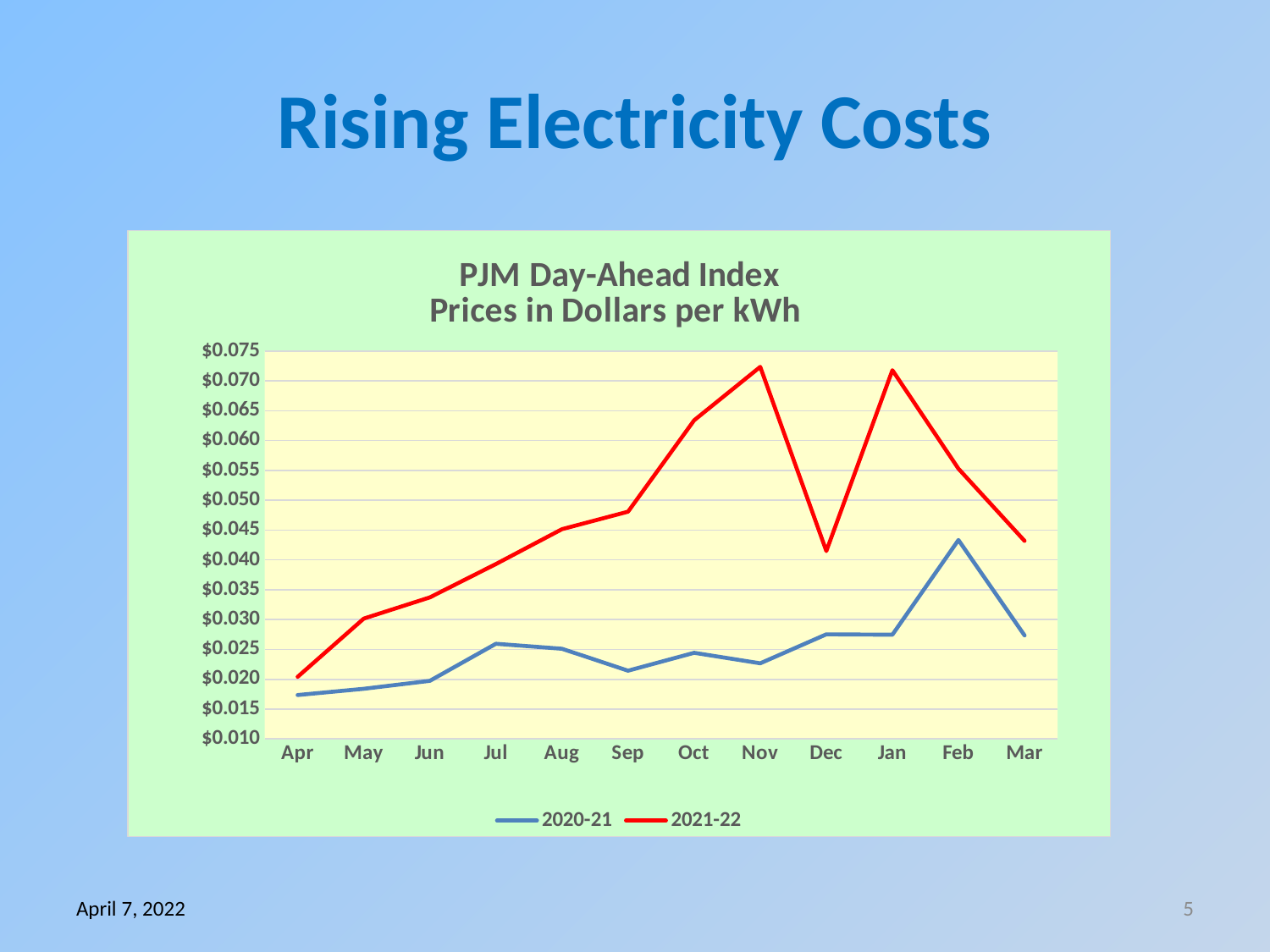
What kind of chart is shown on the slide? line chart Does the 2021-22 series rise or fall from Apr to Nov? rise Is the 2020-21 value for Feb greater or less than $0.040? greater In which month is the 2020-21 series at its highest? Feb Which series has the higher value in Dec, 2020-21 or 2021-22? 2021-22 How many series does the legend list? 2 Is the 2020-21 value for Apr greater or less than $0.020? less Is the 2021-22 value for Dec greater or less than $0.045? less In which month is the 2020-21 series at its lowest? Apr How many months are plotted along the x axis? 12 In which month is the 2021-22 series at its lowest? Apr